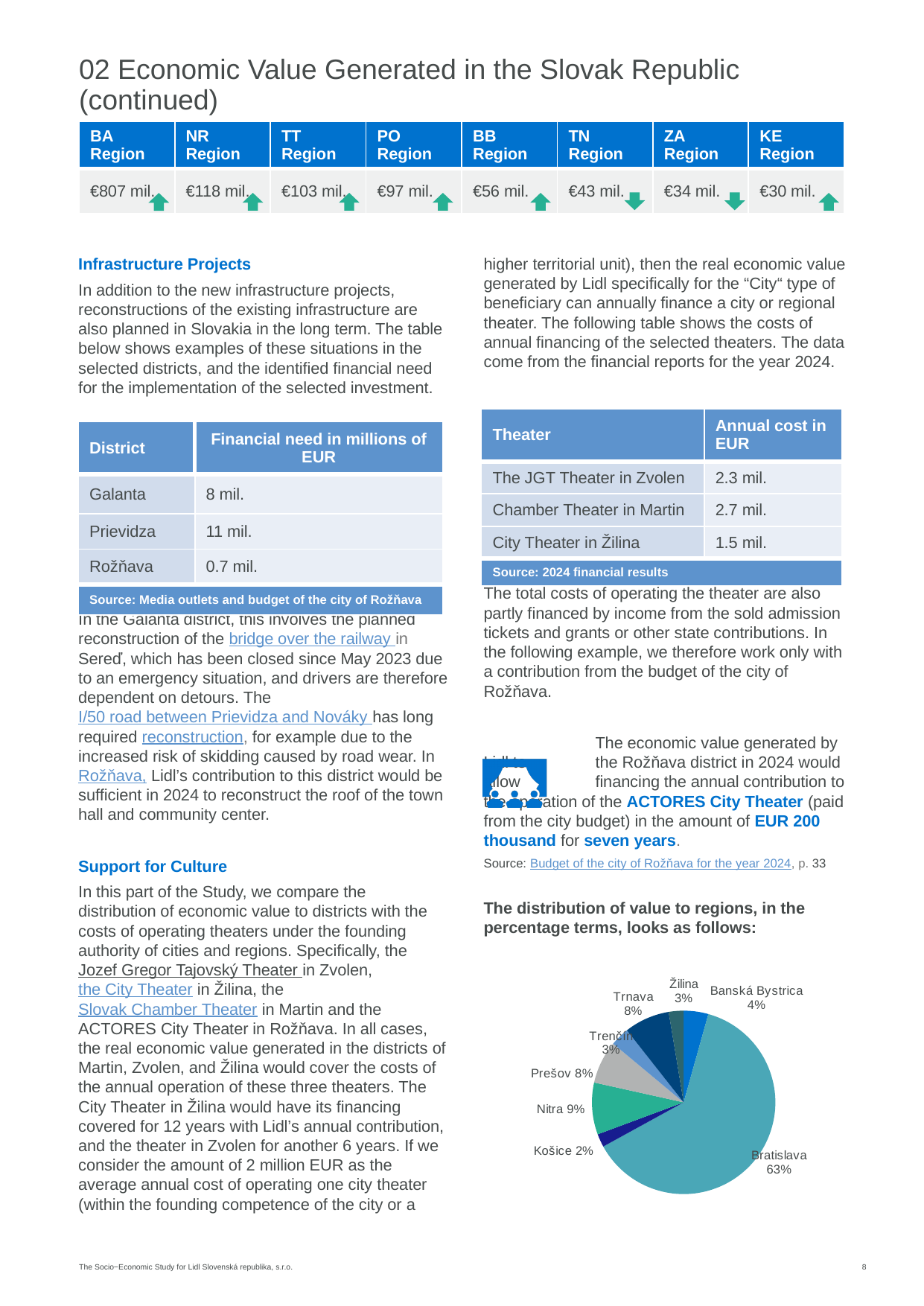
Which region has the smallest slice in the pie chart? Košice In the pie chart, what share of value goes to Košice? 2% In the pie chart, what share of value goes to Bratislava? 63% In the pie chart, what share of value goes to Trnava? 8% In the pie chart, which has the larger share: Nitra or Prešov? Nitra In the pie chart, what is the combined share of Žilina and Trenčín? 6% Which region has the largest slice in the pie chart? Bratislava In the pie chart, how many percentage points larger is Bratislava's share than Nitra's share? 54 percentage points How many regions (slices) are shown in the pie chart? 8 What kind of chart is shown at the bottom right of the slide? pie chart In the pie chart, what share of value goes to Banská Bystrica? 4% In the pie chart, what share of value goes to Nitra? 9%